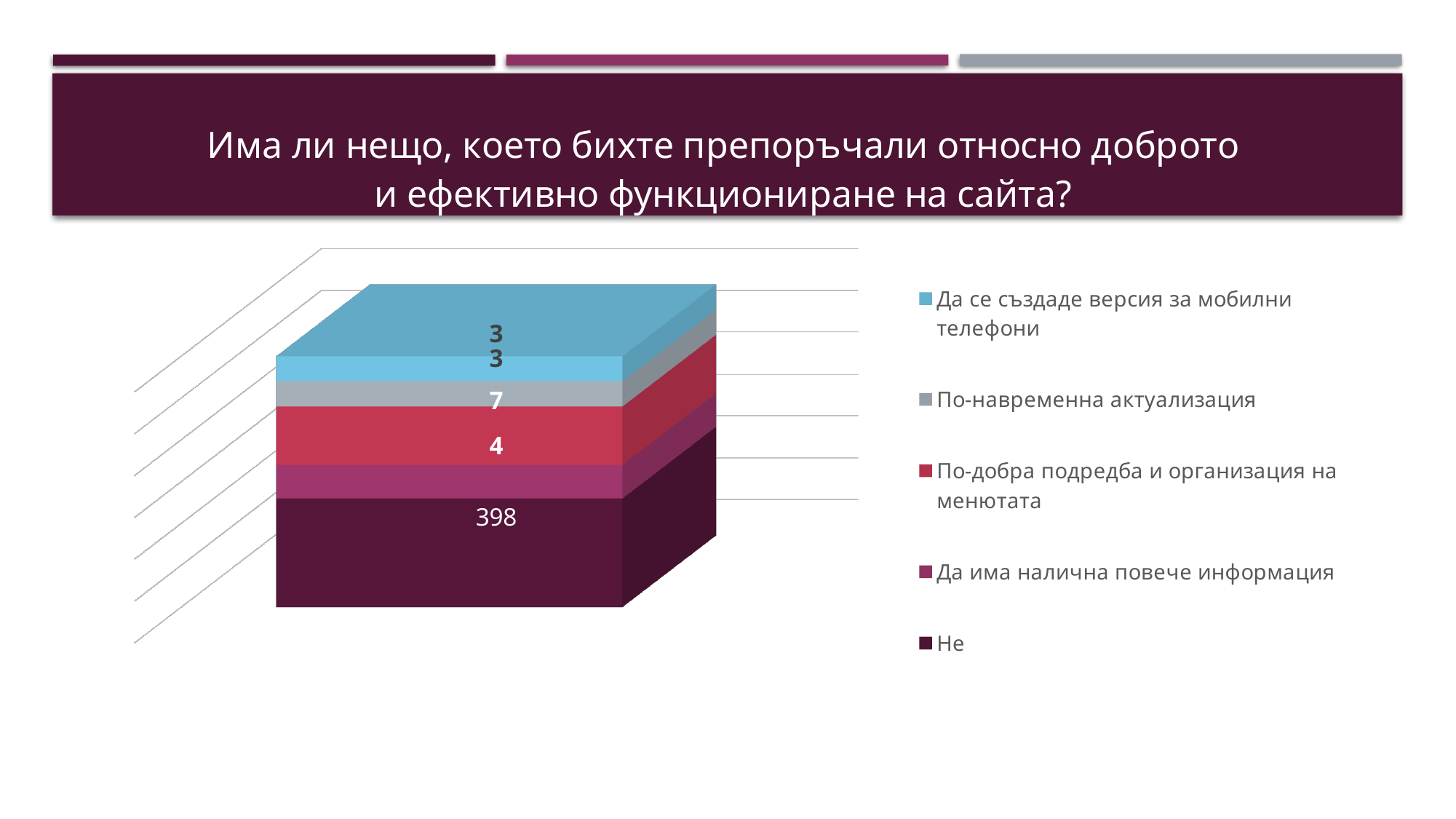
What is the value for "Да се създаде версия за мобилни телефони"? 3 How many series does the legend list? 5 Which is larger: the value for "По-добра подредба и организация на менютата" or for "Да има налична повече информация"? По-добра подредба и организация на менютата Which series is shown in light blue in the legend? Да се създаде версия за мобилни телефони What kind of chart is shown on the slide? Stacked bar chart What is the value for "По-добра подредба и организация на менютата"? 7 What is the total of all segments in the stacked bar? 415 What is the value for the "Не" segment of the bar? 398 Which series has the highest value? Не What is the value for "Да има налична повече информация"? 4 What is the difference between the values for "Не" and "По-добра подредба и организация на менютата"? 391 What is the value for "По-навременна актуализация"? 3